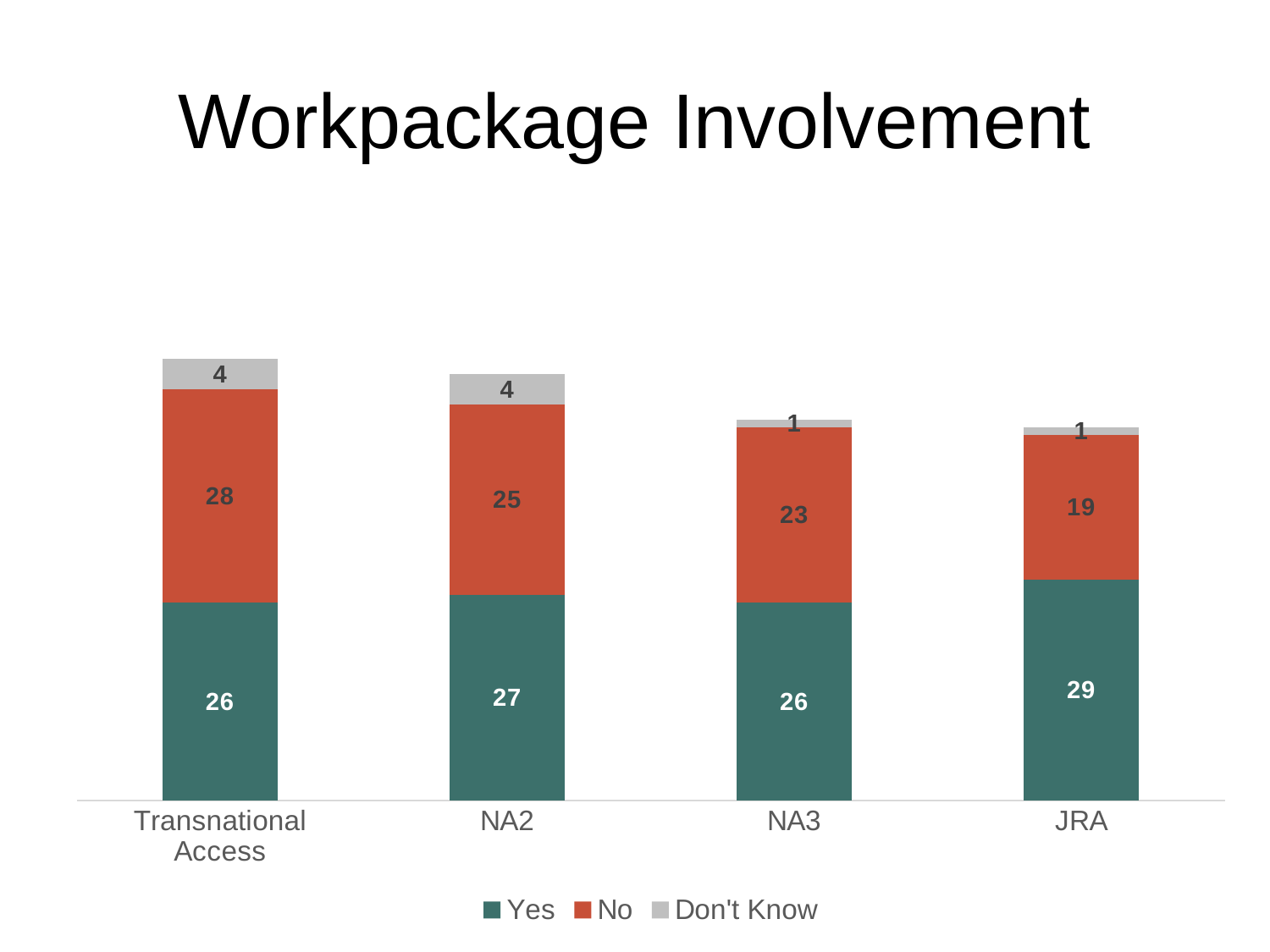
What is the 'Yes' value for JRA? 29 What is the title of the chart? Workpackage Involvement Which category has the lowest 'No' value? JRA How many series does the legend list? 3 What kind of chart is shown on the slide? Stacked bar chart What is the difference between the 'No' values for Transnational Access and JRA? 9 Which category has the highest 'Yes' value? JRA What is the total of the stacked bar for NA3? 50 What is the 'No' value for Transnational Access? 28 How many categories are shown on the x axis? 4 Which is larger, the 'No' value for NA2 or the 'No' value for NA3? NA2 What is the 'Don't Know' value for NA2? 4